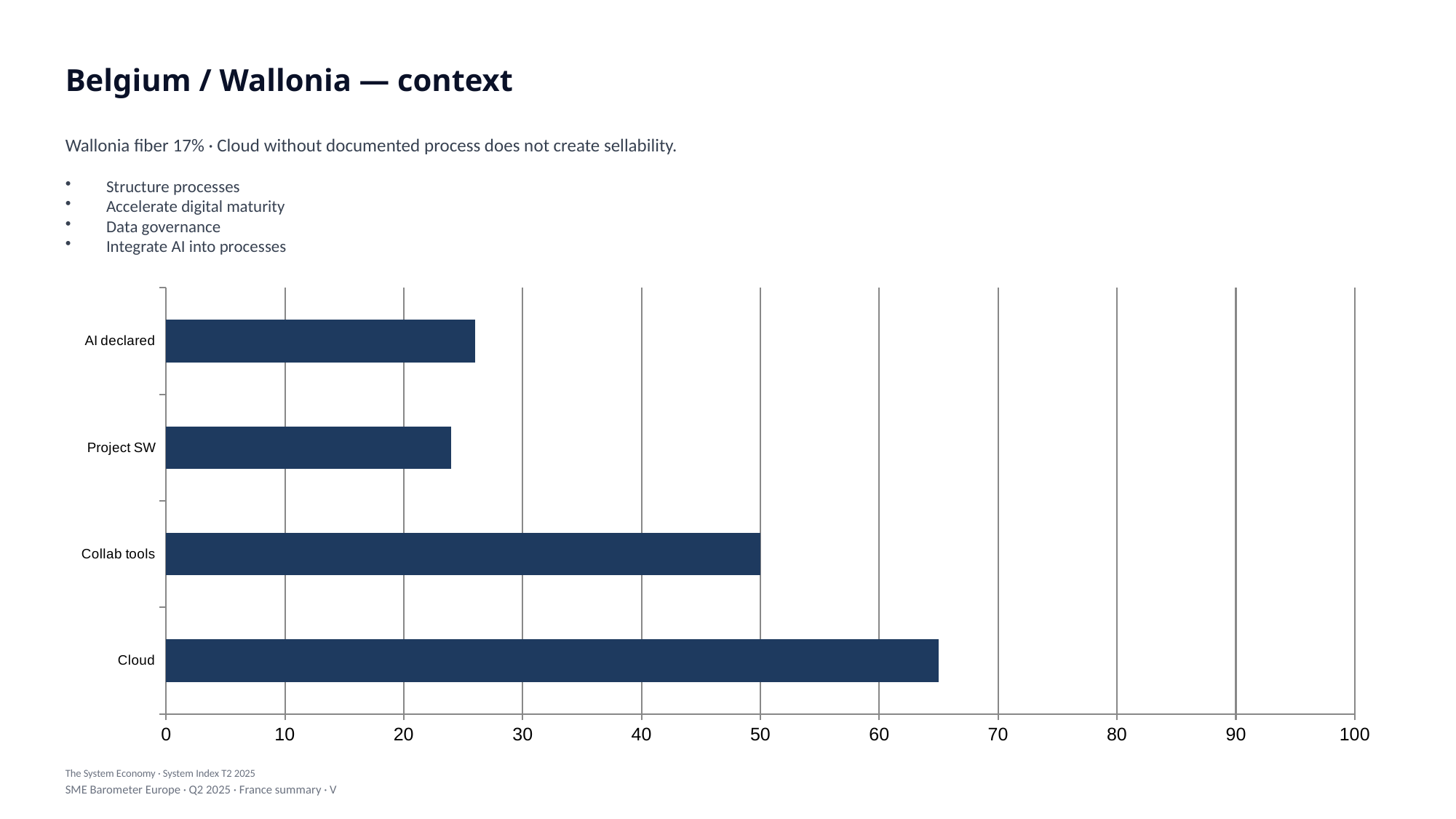
Is the value for AI declared greater or less than 30? less Is the value for Cloud greater or less than 60? greater What kind of chart is shown on the slide? bar chart Which is larger, the value for Collab tools or the value for AI declared? Collab tools Is the value for Cloud greater or less than 70? less What is the value for Collab tools? 50 How many categories are plotted in the chart? 4 Which category is listed at the bottom of the chart? Cloud What is the maximum value shown on the horizontal axis of the chart? 100 Which category has the highest value in the chart? Cloud Which is larger, the value for Cloud or the value for Collab tools? Cloud